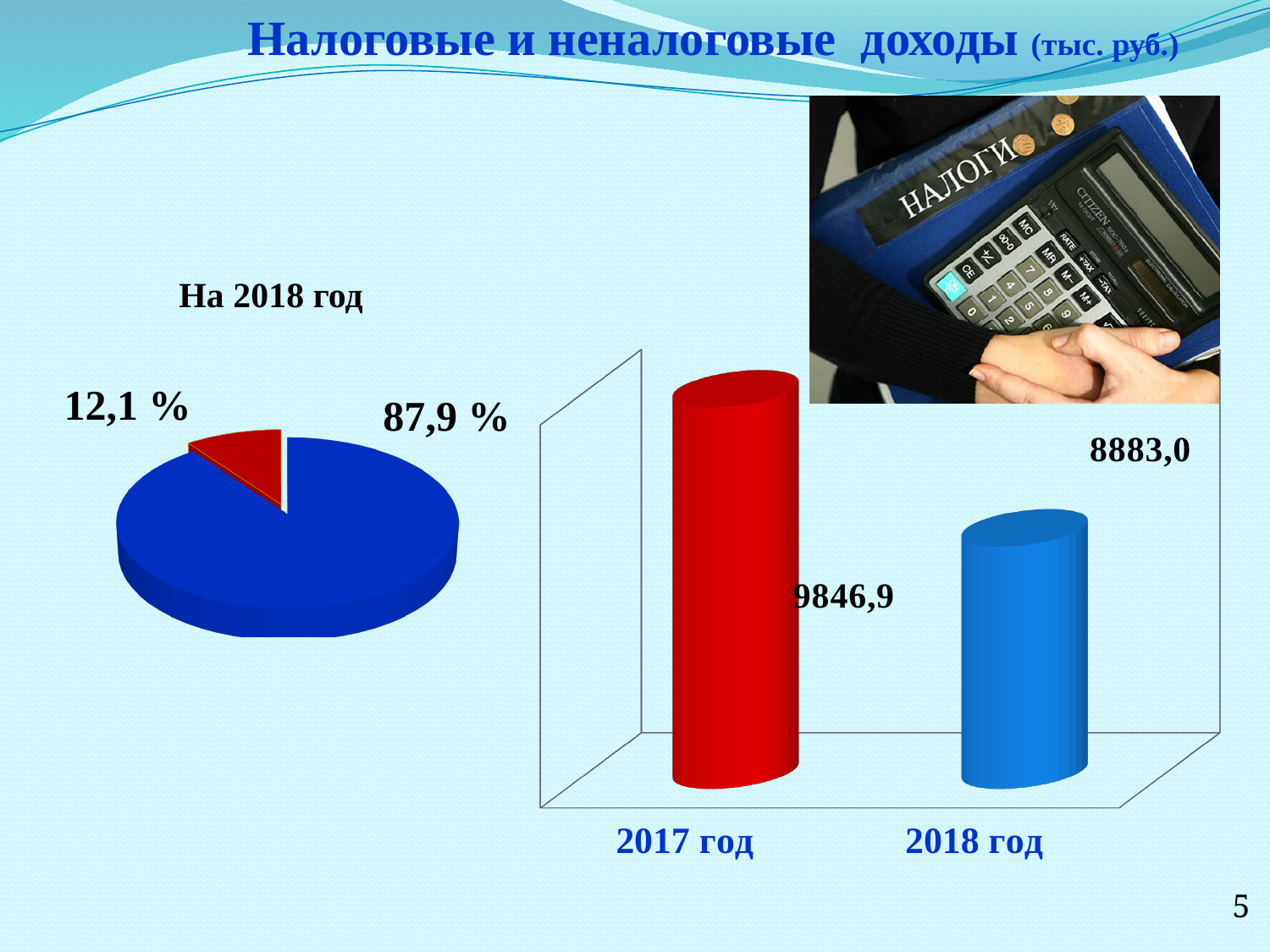
On the bar chart on the right, what is the value for 2018 год? 8883,0 On the bar chart on the right, do the values rise or fall from 2017 год to 2018 год? fall What kind of chart is the chart on the left of the slide? pie chart On the bar chart on the right, which year has the higher value? 2017 год On the bar chart on the right, what is the difference between the values for 2017 год and 2018 год? 963,9 On the bar chart on the right, what is the value for 2017 год? 9846,9 On the pie chart titled 'На 2018 год', what share does the red slice represent? 12,1 % On the bar chart on the right, is the value for 2017 год larger or smaller than the value for 2018 год? larger What kind of chart is the chart on the right of the slide? bar chart On the pie chart titled 'На 2018 год', what share does the blue slice represent? 87,9 % On the bar chart on the right, which year has the lower value? 2018 год On the bar chart on the right, how many bars are shown? 2